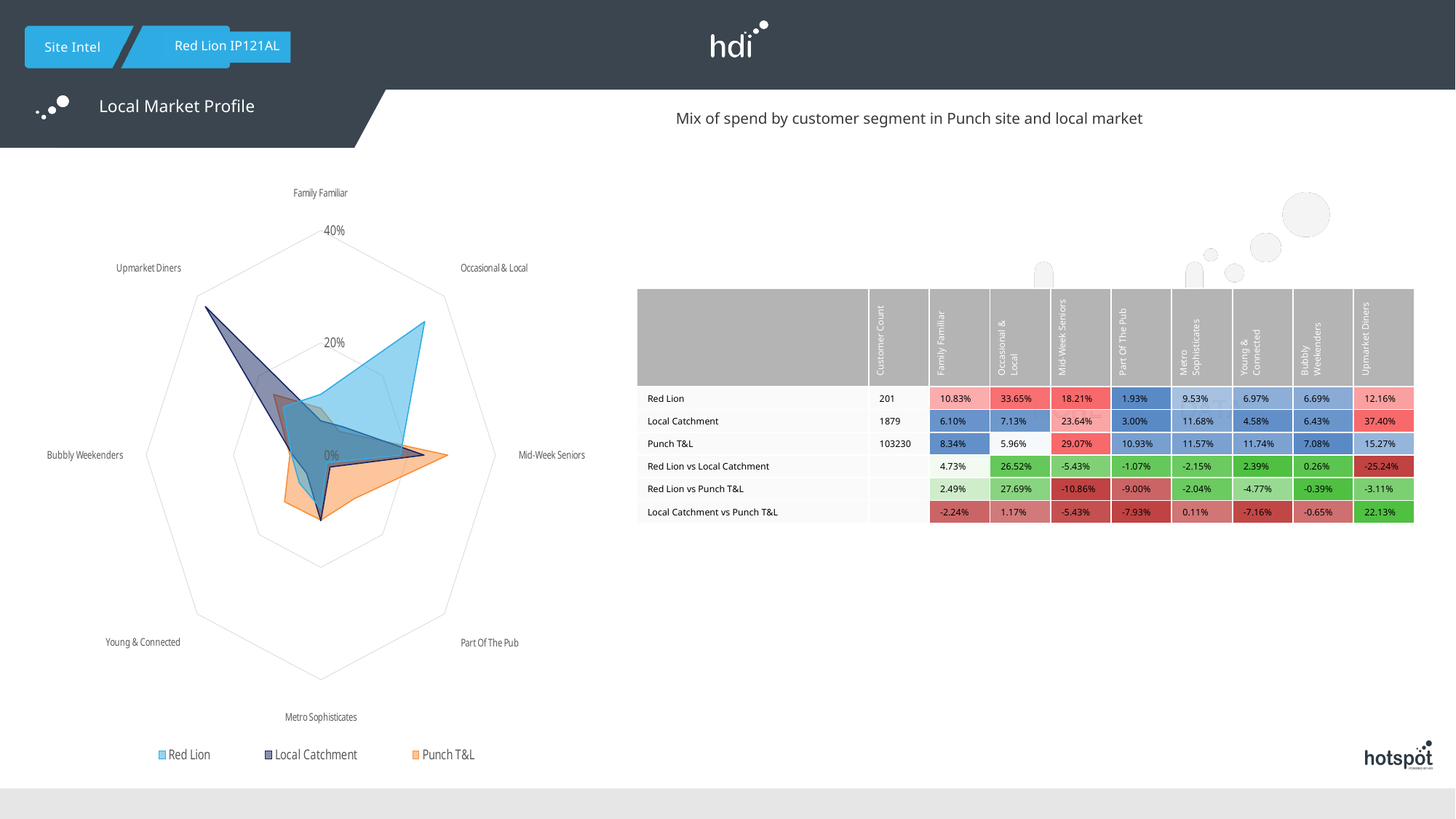
For Mid-Week Seniors, which is larger: Punch T&L or Red Lion? Punch T&L Which customer segment has the highest value for Local Catchment? Upmarket Diners Which customer segment has the lowest value for Red Lion? Part Of The Pub Which customer segment has the highest value for Red Lion? Occasional & Local How many customer segment categories are plotted on the radar chart? 8 Is the Local Catchment value for Upmarket Diners greater or less than 20%? greater What is the highest percentage tick shown on the radar chart's axis? 40% What is the Red Lion value for Occasional & Local? 33.65% Which customer segment has the highest value for Punch T&L? Mid-Week Seniors What is the Local Catchment value for Upmarket Diners? 37.40% What kind of chart is shown on the left of the slide? Radar chart How many series does the legend of the radar chart list? 3